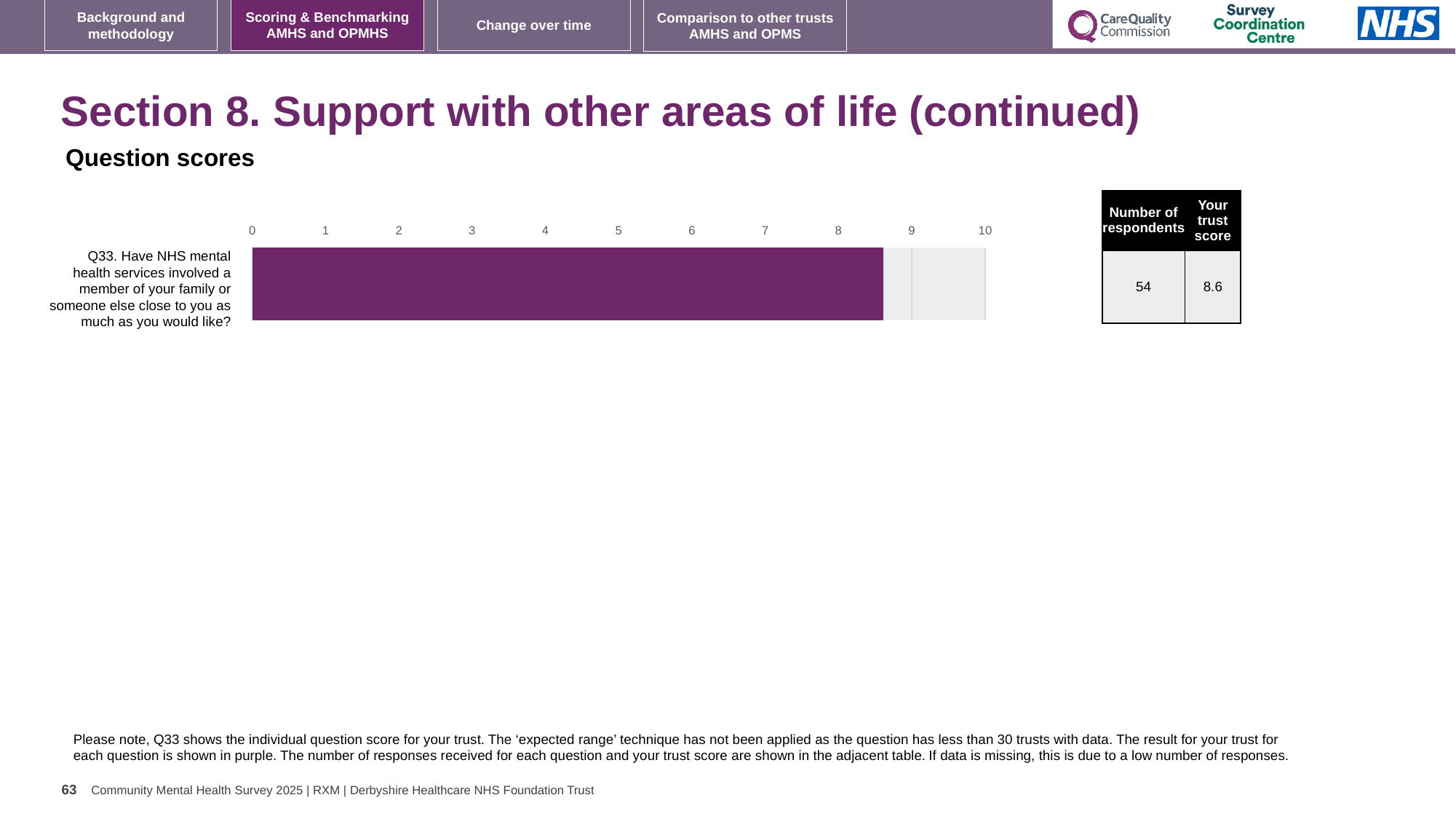
What kind of chart is shown on the slide? bar chart How many respondents answered Q33 according to the table next to the chart? 54 What is the trust score for Q33 (Have NHS mental health services involved a member of your family or someone else close to you as much as you would like?)? 8.6 Is the value for Q33 greater or less than 8? greater Is the value for Q33 greater or less than 9? less Is the value for Q33 greater or less than 5? greater How many questions (categories) are plotted on the chart? 1 What is the maximum value shown on the chart's axis? 10 What colour is the bar showing the trust's result for Q33? purple